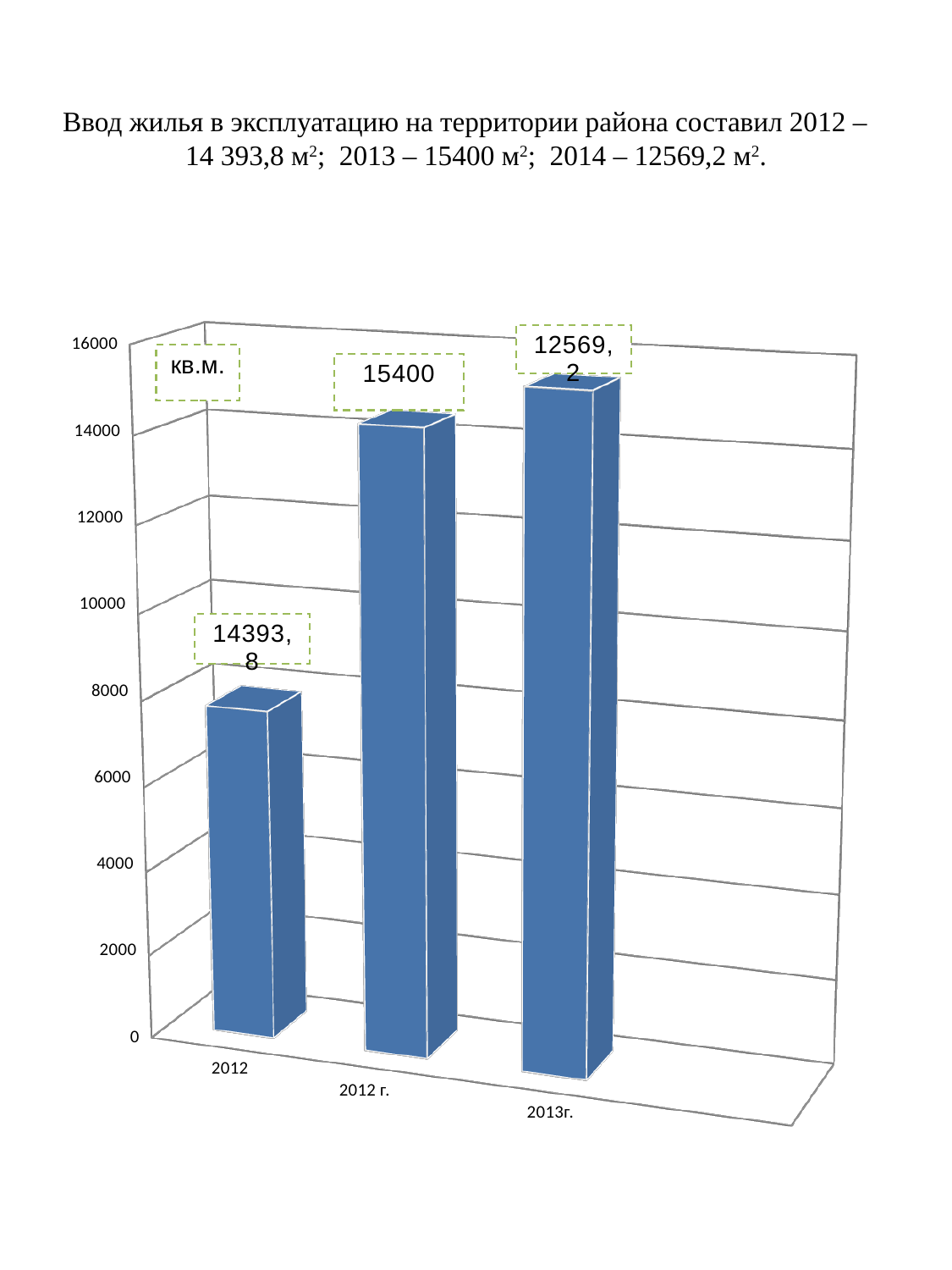
What unit label is shown in the box at the top left of the chart's plot area? кв.м. What is the highest tick value shown on the vertical axis of the chart? 16000 What value is labelled on the middle bar of the chart? 15400 What is the category label under the rightmost bar of the chart? 2013г. What is the difference between the labelled values of the middle bar (15400) and the rightmost bar (12569,2)? 2830,8 What kind of chart is shown on the slide? bar chart What value is labelled on the leftmost bar of the chart? 14393,8 What is the difference between the labelled values of the middle bar (15400) and the leftmost bar (14393,8)? 1006,2 What value is labelled on the rightmost bar of the chart? 12569,2 How many bars are plotted in the chart? 3